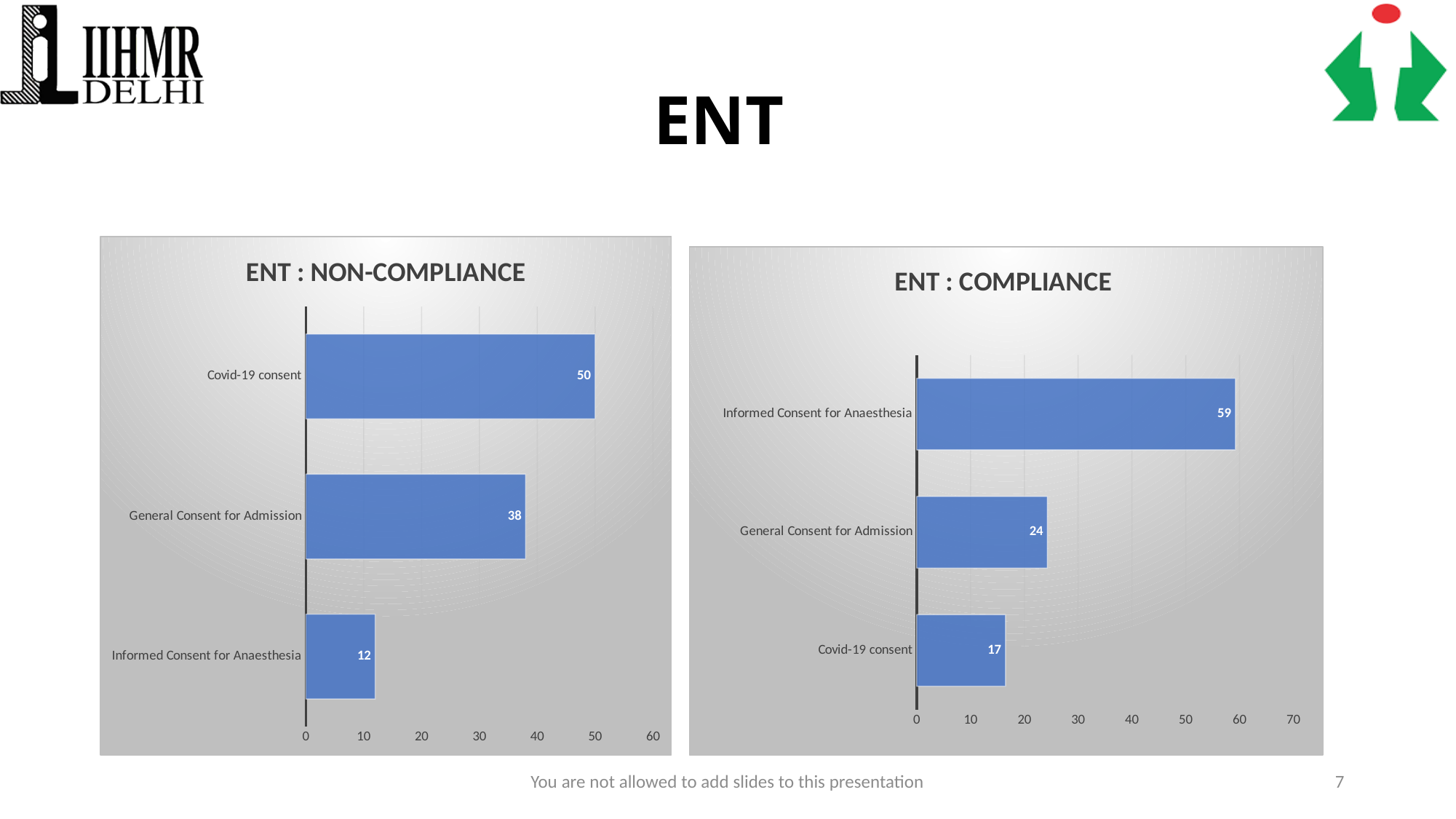
In the ENT : COMPLIANCE chart, which is larger: General Consent for Admission or Covid-19 consent? General Consent for Admission How many categories are shown in the ENT : NON-COMPLIANCE chart? 3 In the ENT : COMPLIANCE chart, what is the value for Informed Consent for Anaesthesia? 59 In the ENT : NON-COMPLIANCE chart, what is the value for General Consent for Admission? 38 In the ENT : COMPLIANCE chart, what is the difference between the values for Informed Consent for Anaesthesia and General Consent for Admission? 35 What is the title of the chart on the left side of the slide? ENT : NON-COMPLIANCE What kind of chart is the ENT : COMPLIANCE chart? Bar chart In the ENT : COMPLIANCE chart, which category has the highest value? Informed Consent for Anaesthesia In the ENT : COMPLIANCE chart, what is the value for Covid-19 consent? 17 In the ENT : NON-COMPLIANCE chart, which category has the lowest value? Informed Consent for Anaesthesia In the ENT : NON-COMPLIANCE chart, what is the difference between the values for Covid-19 consent and Informed Consent for Anaesthesia? 38 In the ENT : NON-COMPLIANCE chart, what is the value for Covid-19 consent? 50